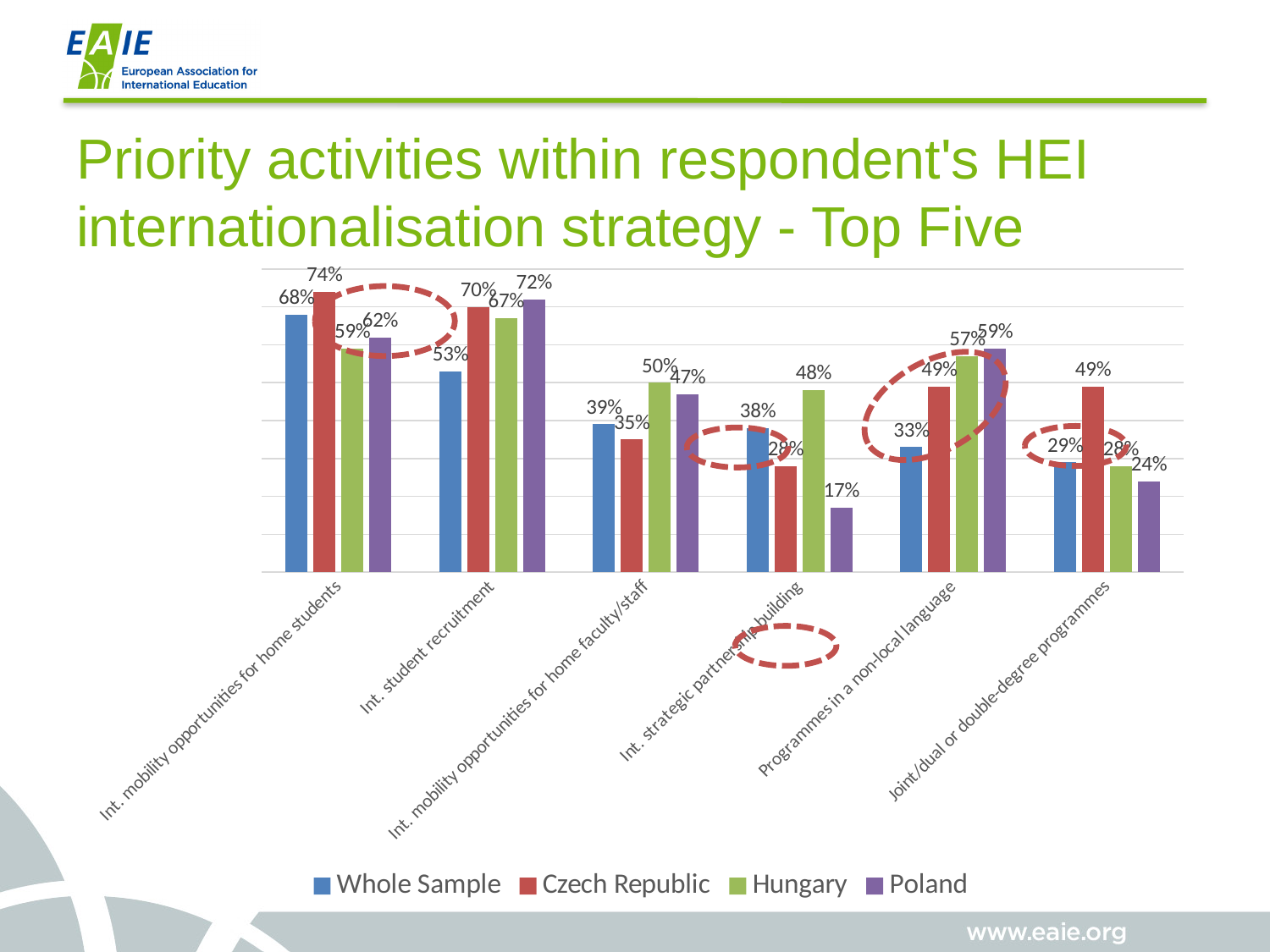
What is the Poland value for Int. strategic partnership building? 17% How many categories are shown on the x axis? 6 What is the Whole Sample value for Programmes in a non-local language? 33% What is the difference between the Czech Republic and Hungary values for Joint/dual or double-degree programmes? 21% Which category has the highest Whole Sample value? Int. mobility opportunities for home students For Int. student recruitment, which is larger: the Whole Sample value or the Poland value? Poland What kind of chart is shown on the slide? Bar chart Which category has the lowest Poland value? Int. strategic partnership building Which series is shown in green in the legend? Hungary What is the Czech Republic value for Int. student recruitment? 70% How many series does the legend list? 4 What is the Hungary value for Int. mobility opportunities for home faculty/staff? 50%